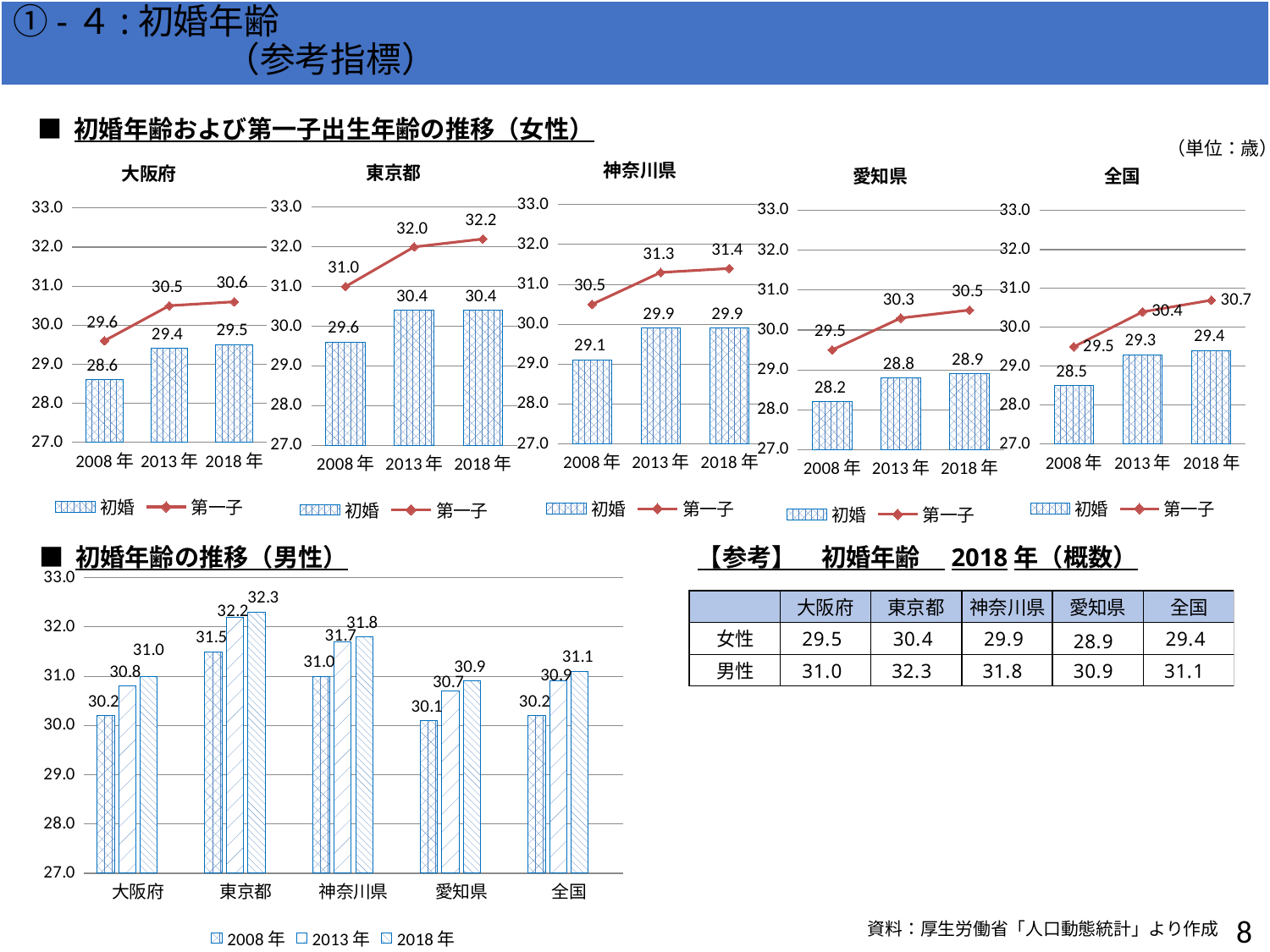
In the 初婚年齢の推移（男性） chart, which prefecture has the highest 2013年 value? 東京都 In the 初婚年齢の推移（男性） chart, how many categories are shown on the x axis? 5 In the 神奈川県 chart under 初婚年齢および第一子出生年齢の推移（女性）, what is the difference between the 第一子 and 初婚 values for 2018年? 1.5 In the 東京都 chart under 初婚年齢および第一子出生年齢の推移（女性）, how many series does the legend list? 2 In the 初婚年齢の推移（男性） chart, which category has the lowest 2008年 value? 愛知県 In the 初婚年齢の推移（男性） chart, what is the 2018年 value for 東京都? 32.3 In the 全国 chart under 初婚年齢および第一子出生年齢の推移（女性）, does the 第一子 line rise or fall from 2008年 to 2018年? rise What kind of chart is the 初婚年齢の推移（男性） chart? bar chart In the 愛知県 chart under 初婚年齢および第一子出生年齢の推移（女性）, what is the 第一子 value for 2013年? 30.3 In the 初婚年齢の推移（男性） chart, what is the difference between the 2018年 and 2008年 values for 神奈川県? 0.8 In the 大阪府 chart under 初婚年齢および第一子出生年齢の推移（女性）, what is the 初婚 value for 2008年? 28.6 In the 東京都 chart under 初婚年齢および第一子出生年齢の推移（女性）, what is the 第一子 value for 2018年? 32.2